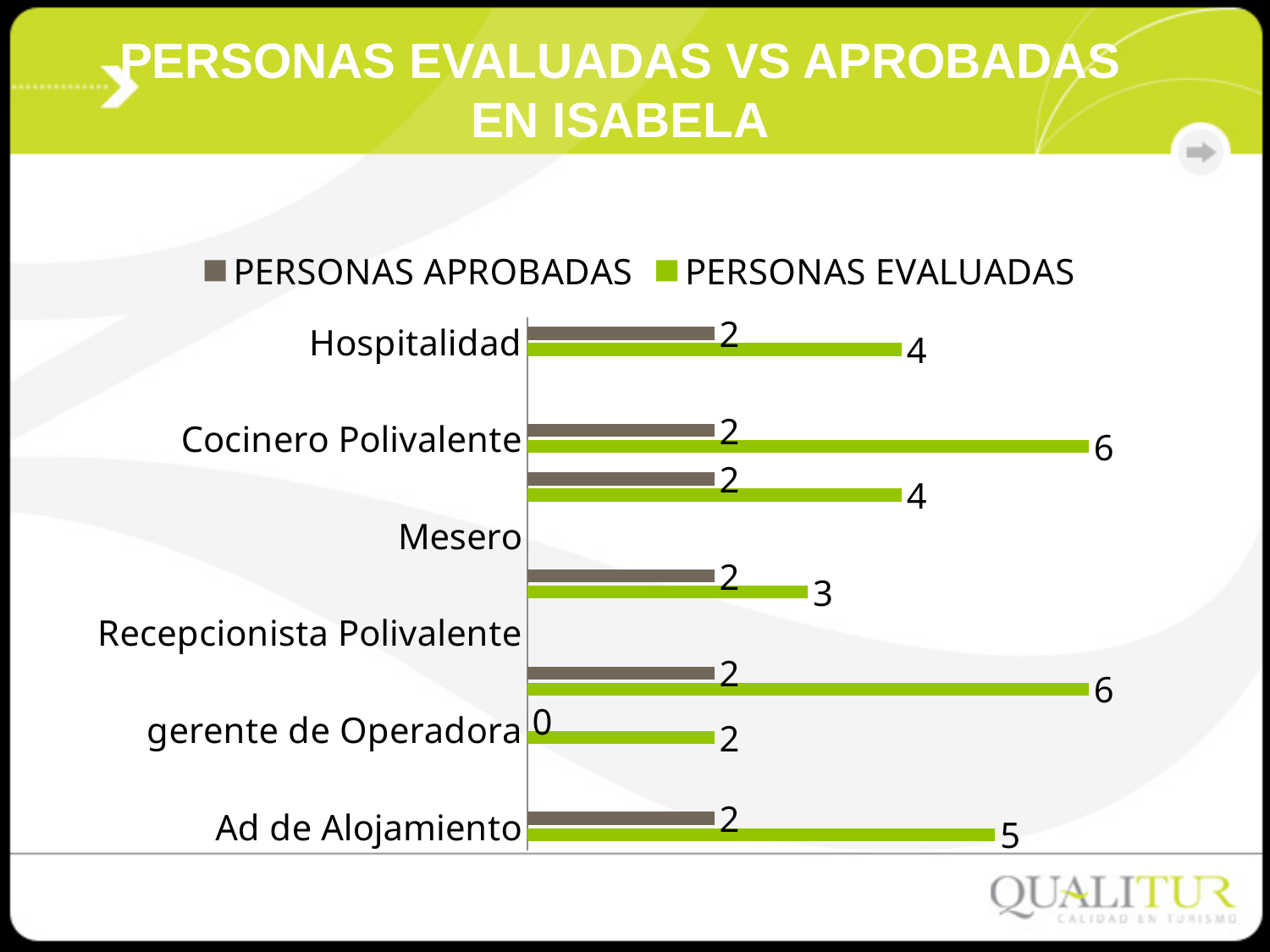
For Ad de Alojamiento, how many more PERSONAS EVALUADAS are there than PERSONAS APROBADAS? 3 What kind of chart is shown on the slide? Bar chart What colour represents the PERSONAS EVALUADAS series? Green How many series does the legend list? 2 Which has more PERSONAS EVALUADAS, Hospitalidad or Ad de Alojamiento? Ad de Alojamiento What is the value of PERSONAS APROBADAS for Hospitalidad? 2 How many PERSONAS EVALUADAS are shown for Hospitalidad? 4 How many PERSONAS EVALUADAS are shown for Ad de Alojamiento? 5 For Cocinero Polivalente, what is the difference between PERSONAS EVALUADAS and PERSONAS APROBADAS? 4 Which category has the lowest value for PERSONAS APROBADAS? gerente de Operadora What is the value of PERSONAS APROBADAS for gerente de Operadora? 0 What is the value of PERSONAS EVALUADAS for Cocinero Polivalente? 6